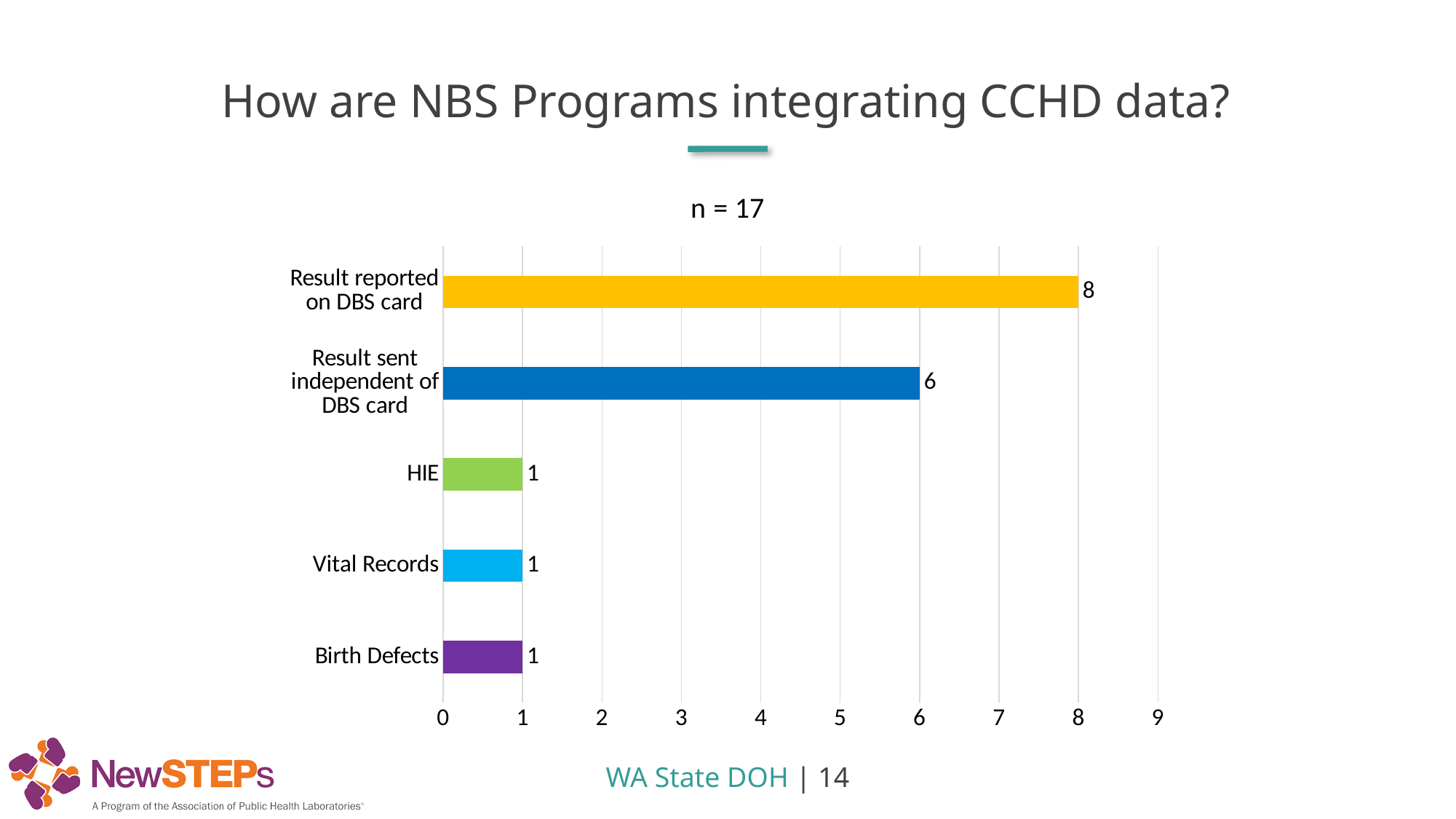
What kind of chart is shown on the slide? Bar chart What is the sample size (n) shown above the chart? n = 17 What is the value for "Result reported on DBS card"? 8 What colour is the bar for Birth Defects? Purple What is the difference between the values for "Result reported on DBS card" and HIE? 7 What is the value for "Result sent independent of DBS card"? 6 What is the difference between the values for "Result reported on DBS card" and "Result sent independent of DBS card"? 2 Which is larger, the value for "Result sent independent of DBS card" or the value for Birth Defects? Result sent independent of DBS card How many categories are shown in the chart? 5 Which category has the highest value? Result reported on DBS card What is the value for Vital Records? 1 What is the value for HIE? 1